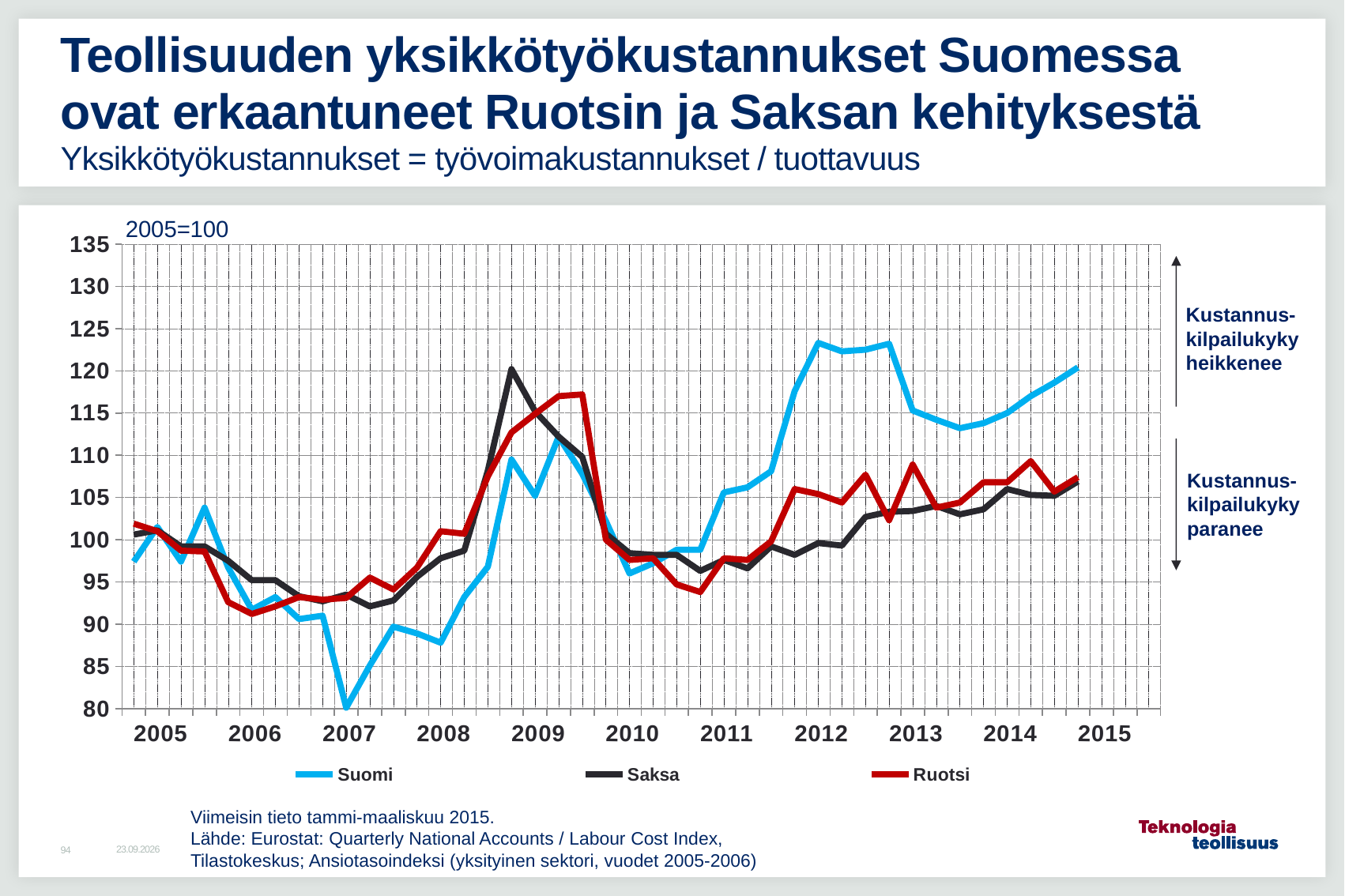
Is the lowest value for Suomi, around the start of 2007, greater or less than 85? less What kind of chart is shown on the slide? line chart Is the value for Saksa at the start of 2015 greater or less than 105? greater How many series does the chart legend list? 3 Which series reaches the highest value anywhere on the chart? Suomi What base year and value is the index set to, as noted above the chart? 2005=100 Which series are listed in the chart legend? Suomi, Saksa, Ruotsi At the start of 2012, which series has the higher value, Suomi or Saksa? Suomi Which series has the lowest value anywhere on the chart? Suomi Is the peak value for Ruotsi in 2009 greater or less than 115? greater